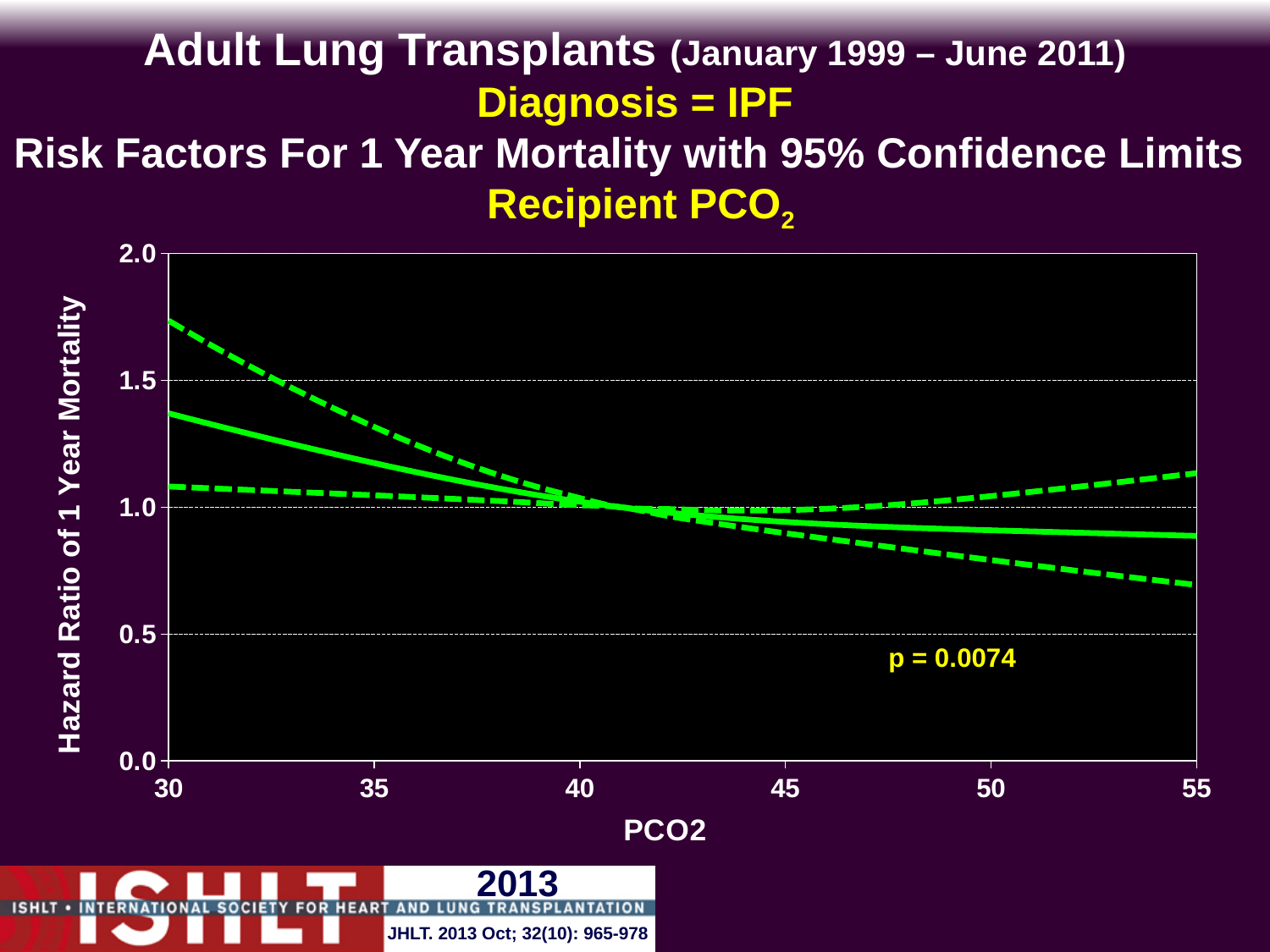
Is the upper confidence limit (upper dashed line) at PCO2 = 55 greater or less than 1.5? less Is the hazard ratio on the solid line at PCO2 = 30 greater or less than 1.5? less How many lines (solid and dashed) are plotted on the chart? 3 What kind of chart is shown on the slide? line chart Is the upper confidence limit (upper dashed line) at PCO2 = 30 greater or less than 1.5? greater What is the label of the y axis? Hazard Ratio of 1 Year Mortality What p-value is printed on the chart? p = 0.0074 Does the solid hazard ratio line rise or fall as PCO2 increases from 30 to 55? fall